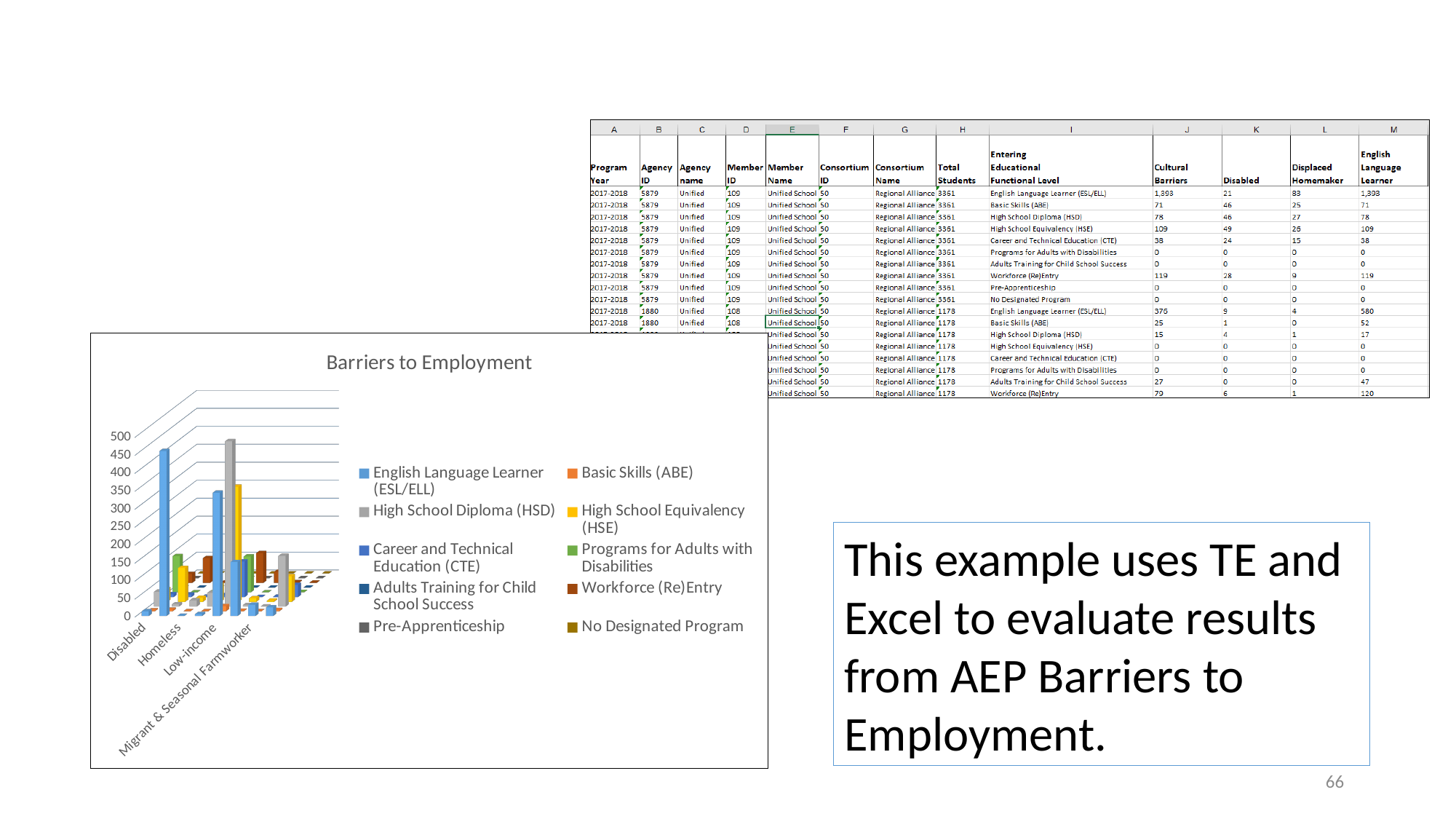
Which category is listed last on the x axis of the chart? Migrant & Seasonal Farmworker What is the highest value shown on the chart's vertical axis? 500 Is the English Language Learner (ESL/ELL) value for Disabled greater or less than 300? less Is the English Language Learner (ESL/ELL) value for Migrant & Seasonal Farmworker greater or less than 100? less How many series does the chart's legend list? 10 What is the title of the chart on the slide? Barriers to Employment What kind of chart is shown on the slide? bar chart